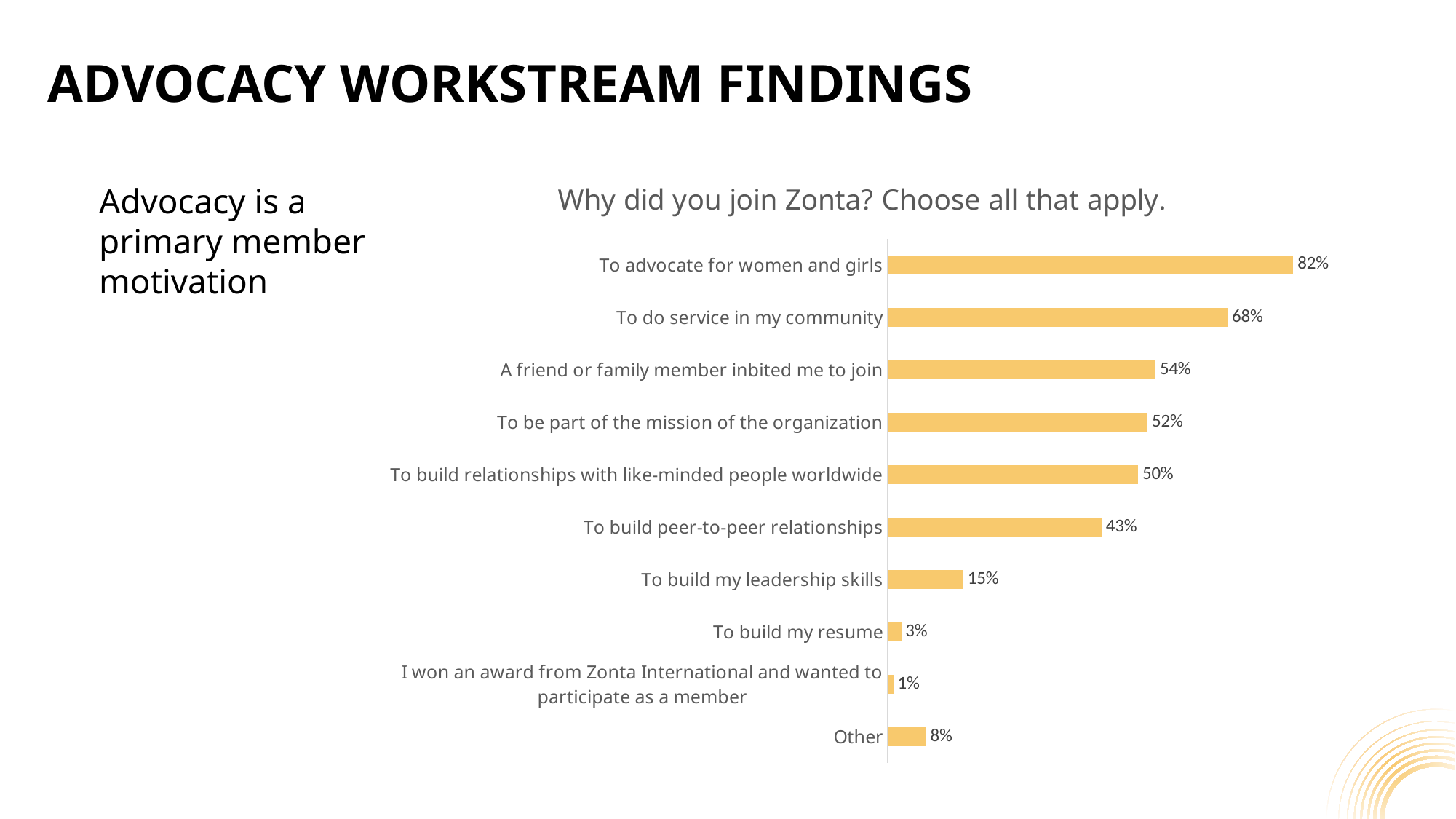
What is the difference between 'To build my resume' and 'Other'? 5% Which reason for joining Zonta has the lowest percentage? I won an award from Zonta International and wanted to participate as a member What is the value for 'Other'? 8% What is the value for 'To do service in my community'? 68% What kind of chart is shown on the slide? Bar chart How many reasons for joining are listed in the chart? 10 Which reason for joining Zonta has the highest percentage? To advocate for women and girls What is the difference between 'To advocate for women and girls' and 'To do service in my community'? 14% What percentage chose 'To build my leadership skills'? 15% Which is larger: 'To build peer-to-peer relationships' or 'To build my leadership skills'? To build peer-to-peer relationships What is the title of the chart? Why did you join Zonta? Choose all that apply. What percentage of respondents said they joined Zonta to advocate for women and girls? 82%